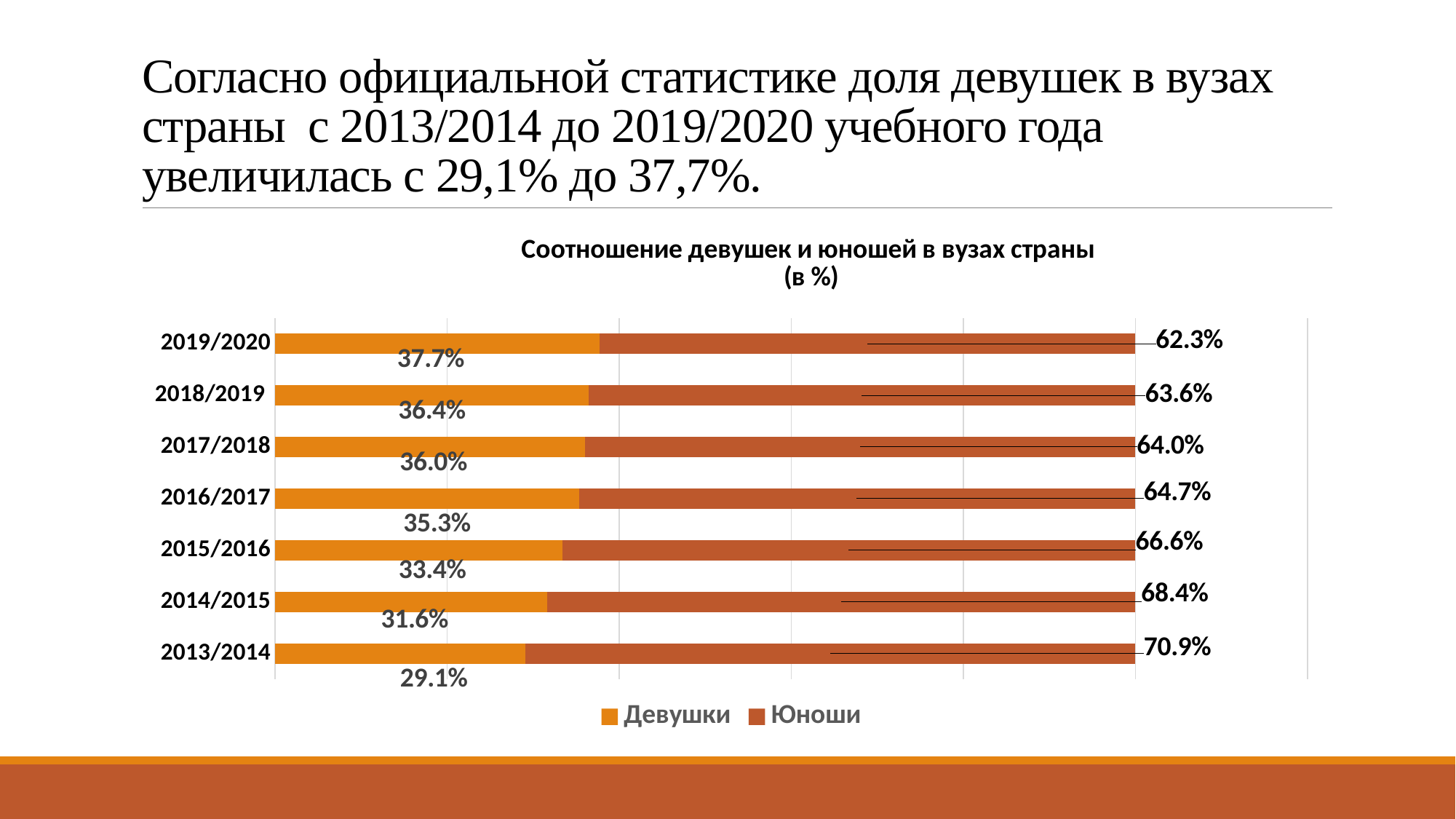
How many series does the legend list? 2 What is the difference between the Девушки values for 2019/2020 and 2013/2014? 8.6% Does the value for Девушки rise or fall from 2013/2014 to 2019/2020? Rises How many academic years are shown on the chart? 7 What is the value for Юноши in 2013/2014? 70.9% In which academic year is the value for Юноши the lowest? 2019/2020 What is the value for Юноши in 2017/2018? 64.0% Which is larger in 2016/2017: the value for Девушки or the value for Юноши? Юноши What is the value for Девушки in 2019/2020? 37.7% In which academic year is the value for Девушки the highest? 2019/2020 What is the value for Девушки in 2015/2016? 33.4% What kind of chart is shown on the slide? Stacked bar chart